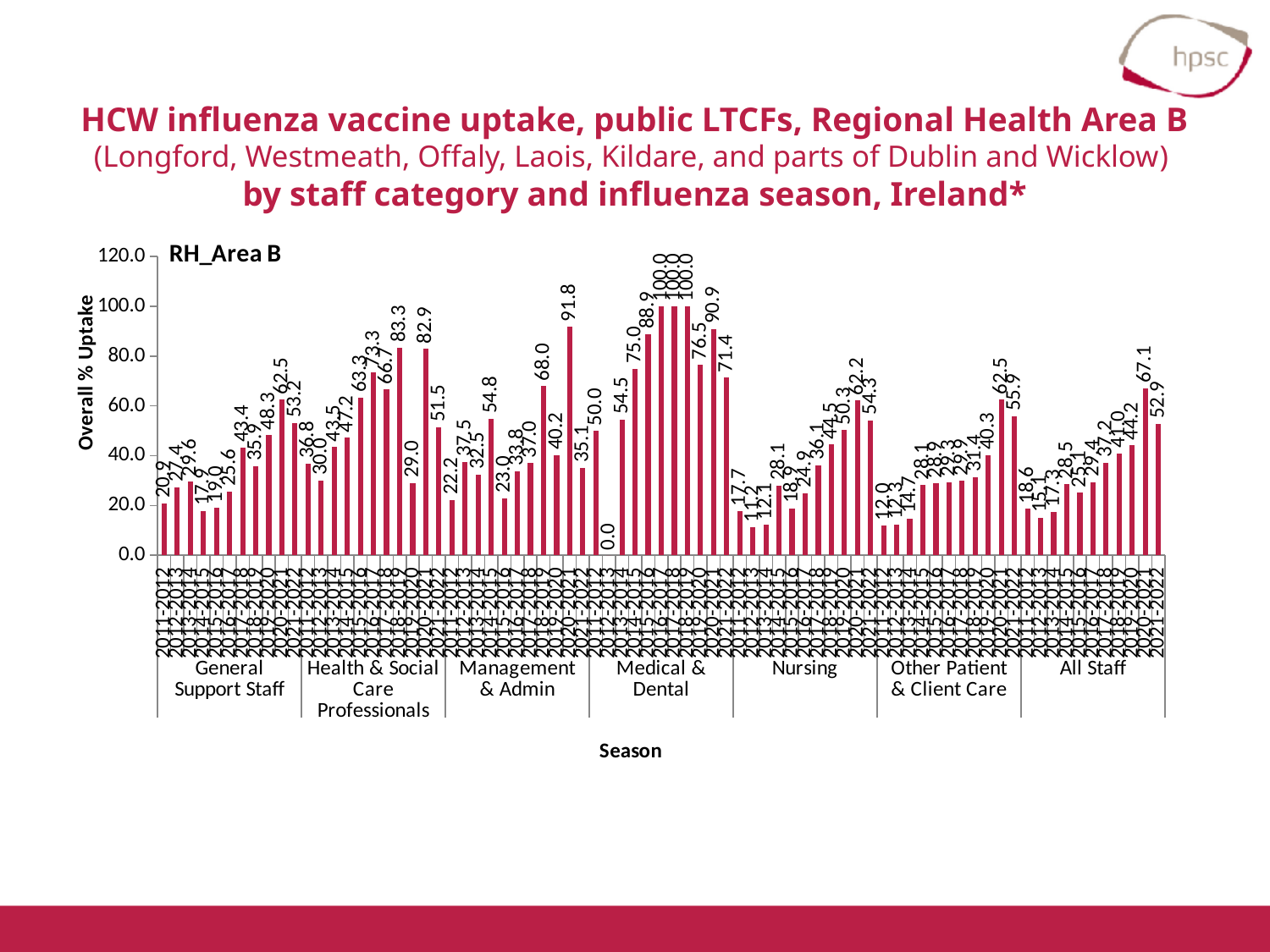
Is the highest value for the Nursing category greater or less than 80? less How many staff categories are shown along the x axis of the chart? 7 What is the value for All Staff in the 2021-2022 season? 52.9 What kind of chart is shown on the slide? bar chart What is the title of the y axis? Overall % Uptake What is the highest value shown for the Medical & Dental staff category? 100.0 What is the highest value shown for the All Staff category? 67.1 What is the title of the x axis? Season Which is larger: the highest Health & Social Care Professionals value (83.3) or the highest Management & Admin value (91.8)? Management & Admin (91.8) What is the lowest value shown for the Medical & Dental staff category? 0.0 What is the highest value shown for the Management & Admin staff category? 91.8 What is the difference between the All Staff values for 2020-2021 (67.1) and 2021-2022 (52.9)? 14.2